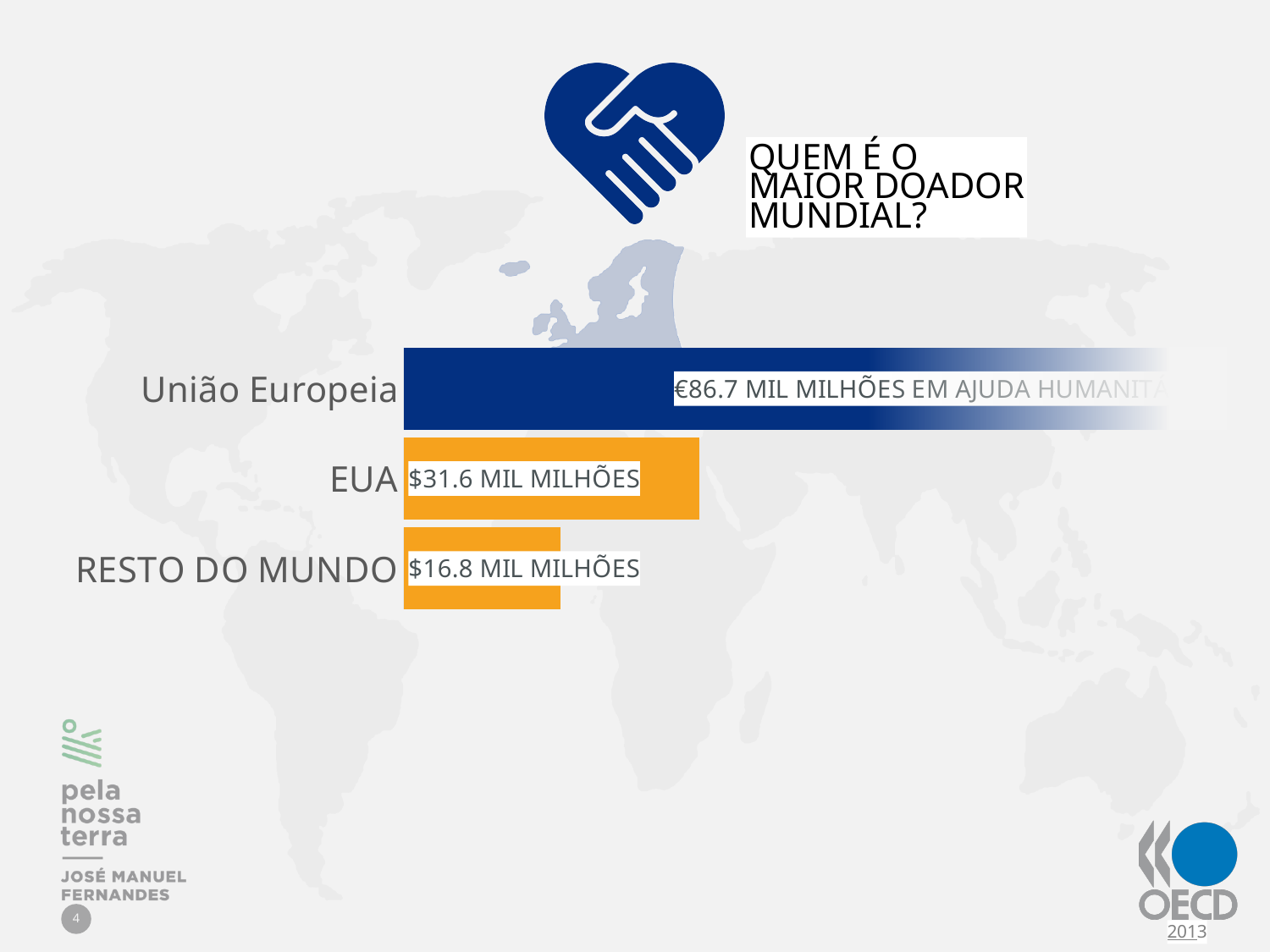
What kind of chart is shown on the slide? Bar chart How many categories are shown in the chart? 3 Which is larger, the value for EUA or the value for RESTO DO MUNDO? EUA What colour is the bar for União Europeia? Blue Which category has the largest bar? União Europeia What is the difference between the values for EUA and RESTO DO MUNDO? $14.8 MIL MILHÕES Which category has the smallest bar? RESTO DO MUNDO What value is shown for RESTO DO MUNDO? $16.8 MIL MILHÕES What value is shown for União Europeia? €86.7 MIL MILHÕES What is the title question shown above the chart? QUEM É O MAIOR DOADOR MUNDIAL? What value is shown for EUA? $31.6 MIL MILHÕES